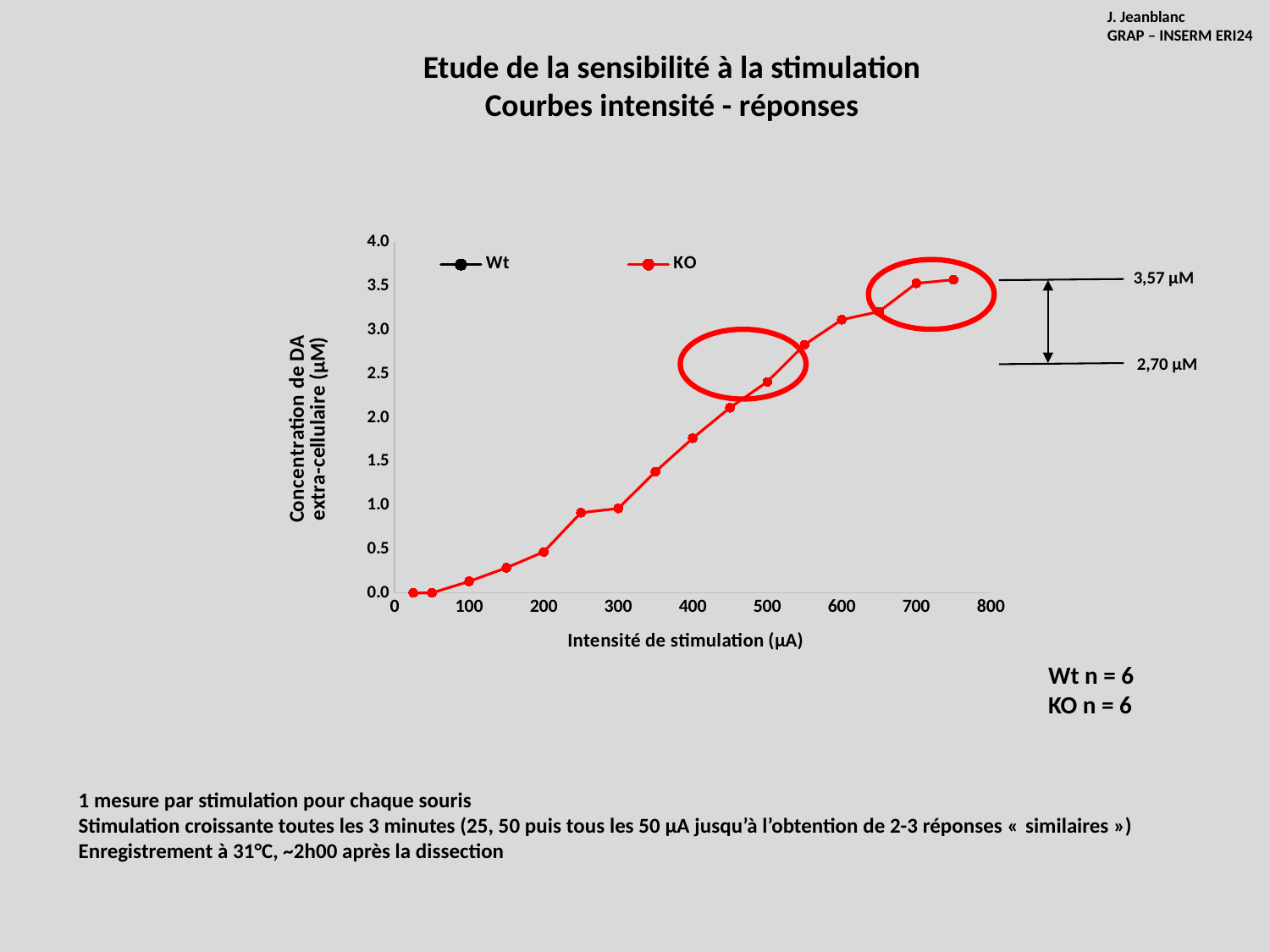
What is the lower annotated concentration value marked to the right of the chart? 2,70 µM Is the KO value at 250 µA greater or less than 0.5? greater Does the KO curve rise or fall as stimulation intensity increases? rise What kind of chart is shown on the slide? line chart What is the upper annotated concentration value marked to the right of the chart? 3,57 µM Is the KO value at 400 µA greater or less than 1.5? greater Is the KO value at 700 µA greater or less than 3.0? greater How many series does the legend list? 2 What are the two series named in the legend? Wt and KO What is the title of the x axis? Intensité de stimulation (µA)